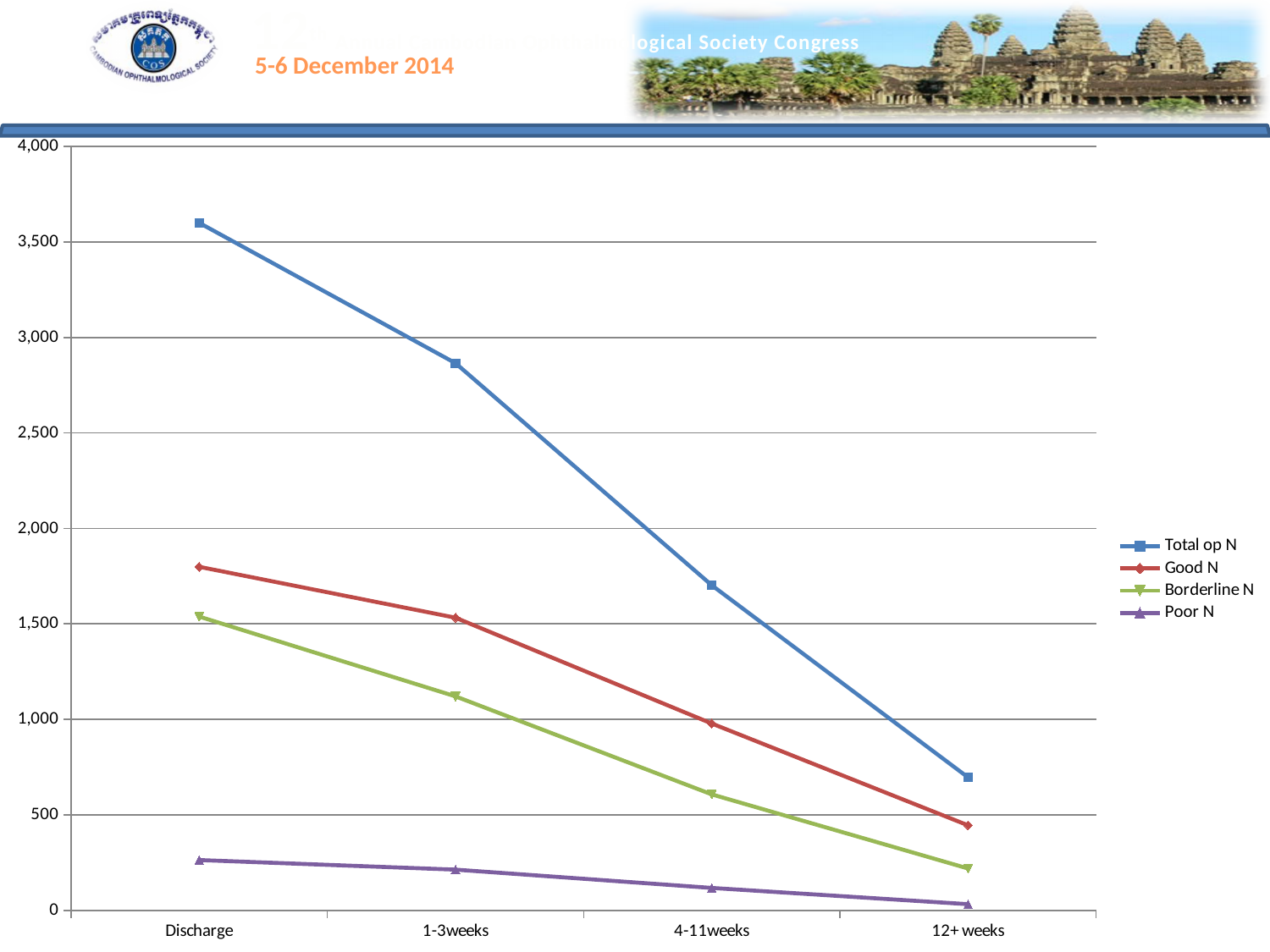
Is the value for Good N at 12+ weeks greater or less than 500? less Is the value for Total op N at 1-3weeks greater or less than 3,000? less How many categories are shown on the x axis? 4 At 1-3weeks, which is larger: Good N or Borderline N? Good N Which series is listed first in the legend? Total op N How many series does the legend list? 4 Which category has the highest value for Total op N? Discharge Which series has the lowest value at Discharge? Poor N What kind of chart is shown on the slide? line chart Do the values for Total op N rise or fall from Discharge to 12+ weeks? fall Which category has the lowest value for Poor N? 12+ weeks Is the value for Total op N at Discharge greater or less than 3,500? greater